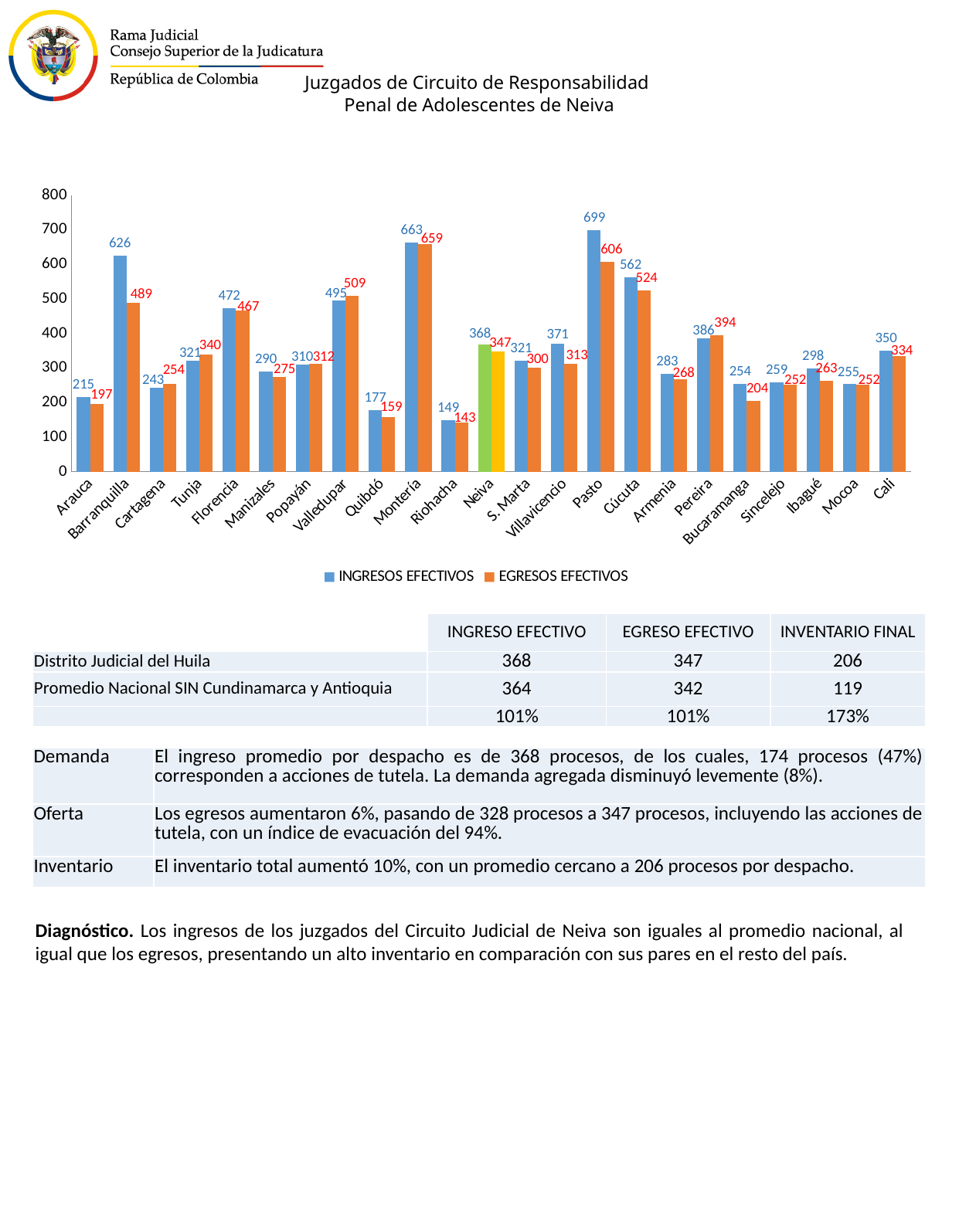
Which city has the lowest EGRESOS EFECTIVOS value? Riohacha Is the INGRESOS EFECTIVOS value for Montería greater or less than 600? greater What is the difference between INGRESOS EFECTIVOS and EGRESOS EFECTIVOS for Pasto? 93 How many cities are shown on the x axis of the chart? 23 Which city's bars are highlighted in green and yellow instead of the standard colours? Neiva What is the INGRESOS EFECTIVOS value for Neiva? 368 What kind of chart is shown on the slide? bar chart Which is larger for Valledupar, INGRESOS EFECTIVOS or EGRESOS EFECTIVOS? EGRESOS EFECTIVOS What is the EGRESOS EFECTIVOS value for Barranquilla? 489 How many series does the chart legend list? 2 Which city has the highest INGRESOS EFECTIVOS value? Pasto What is the EGRESOS EFECTIVOS value for Bucaramanga? 204